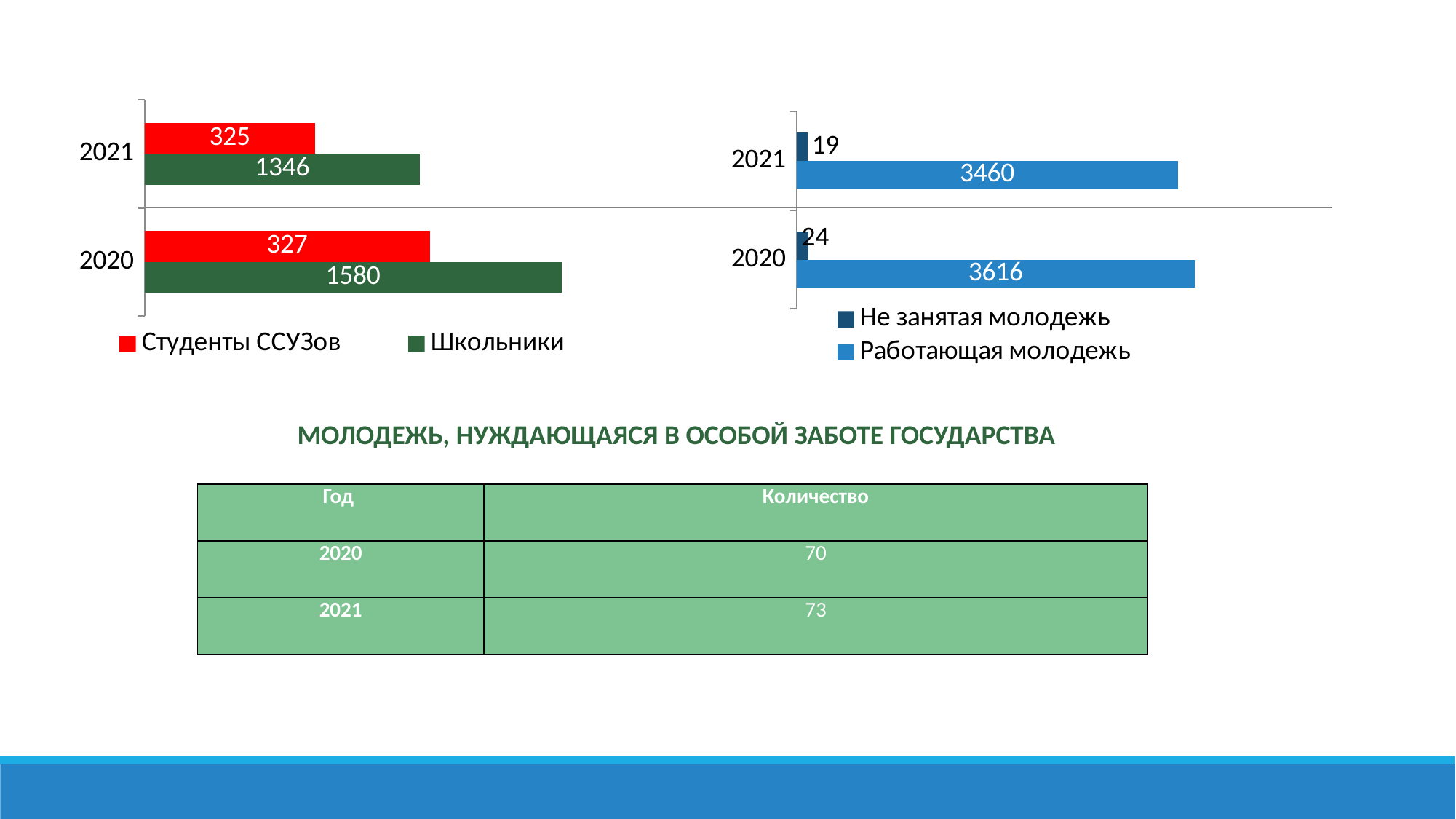
In the left chart, which year has the higher value for Студенты ССУЗов? 2020 In the left chart, what is the value for Школьники in 2020? 1580 In the left chart, which series is shown in red? Студенты ССУЗов How many year categories are shown in the left chart? 2 How many series does the legend of the right chart list? 2 What kind of chart is the left chart? Bar chart In the right chart, what is the value for Не занятая молодежь in 2020? 24 In the right chart, what is the difference between the Работающая молодежь values for 2020 and 2021? 156 In the left chart, what is the difference between the Школьники values for 2020 and 2021? 234 In the right chart, which year has the lower value for Не занятая молодежь? 2021 In the right chart, what is the value for Работающая молодежь in 2021? 3460 In the left chart, what is the value for Студенты ССУЗов in 2021? 325